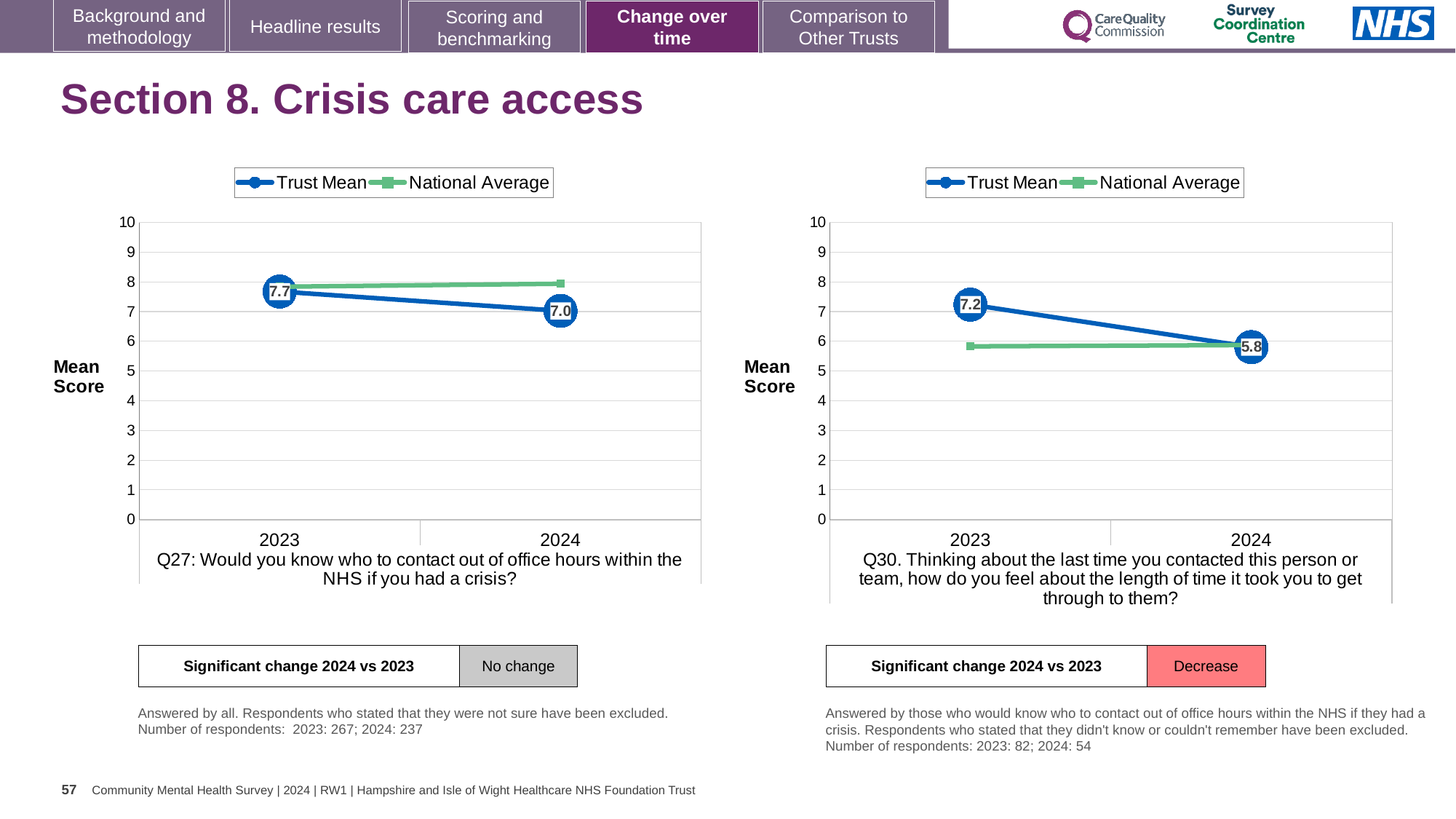
In the Q30 chart on the right, what is the Trust Mean score for 2023? 7.2 In the Q30 chart on the right, which is higher in 2023: the Trust Mean or the National Average? Trust Mean In the Q30 chart on the right, by how much did the Trust Mean fall from 2023 to 2024? 1.4 How many series does the legend of the Q27 chart on the left list? 2 In the Q30 chart on the right, what is the Trust Mean score for 2024? 5.8 In the Q27 chart on the left, is the National Average for 2024 greater or less than 7? greater In the Q27 chart on the left, what is the Trust Mean score for 2024? 7.0 In the Q27 chart on the left, does the Trust Mean rise or fall from 2023 to 2024? fall What kind of chart is the Q30 chart on the right? line chart In the Q27 chart on the left, what is the difference between the Trust Mean in 2023 and 2024? 0.7 What does the box below the Q30 chart on the right say about the significant change 2024 vs 2023? Decrease In the Q27 chart on the left, what is the Trust Mean score for 2023? 7.7